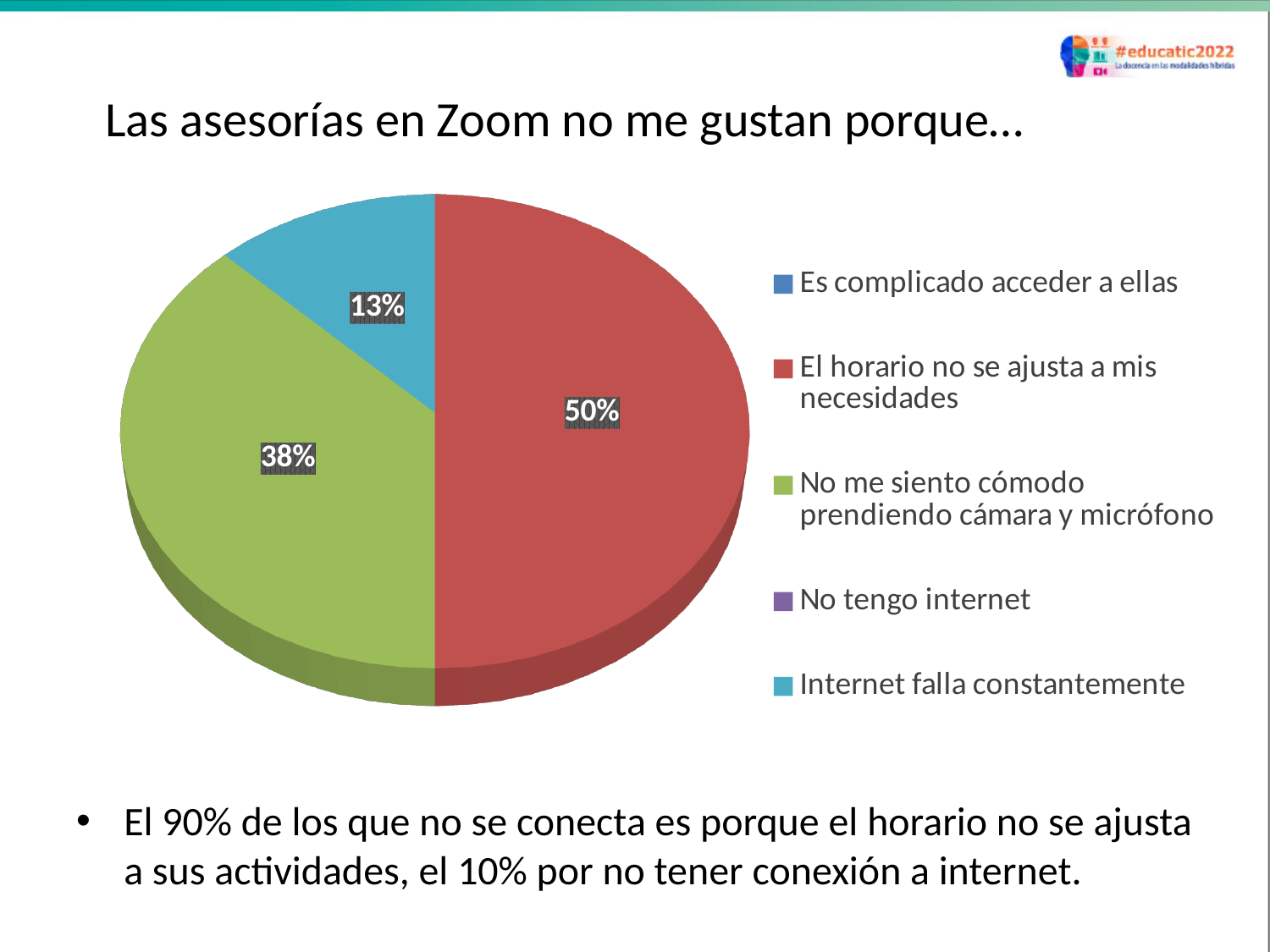
What type of chart is shown on the slide? pie chart Which category has the largest slice of the pie? El horario no se ajusta a mis necesidades Which of the visible slices is the smallest? Internet falla constantemente What share of the pie corresponds to "No me siento cómodo prendiendo cámara y micrófono"? 38% How many slices with data labels are visible in the pie? 3 What share of the pie corresponds to "El horario no se ajusta a mis necesidades"? 50% What is the title of the chart? Las asesorías en Zoom no me gustan porque… What is the difference in percentage points between the "El horario no se ajusta a mis necesidades" slice and the "Internet falla constantemente" slice? 37 Which slice is larger: "No me siento cómodo prendiendo cámara y micrófono" or "Internet falla constantemente"? No me siento cómodo prendiendo cámara y micrófono What share of the pie corresponds to "Internet falla constantemente"? 13% What colour is the slice for "El horario no se ajusta a mis necesidades"? red How many entries does the legend list? 5